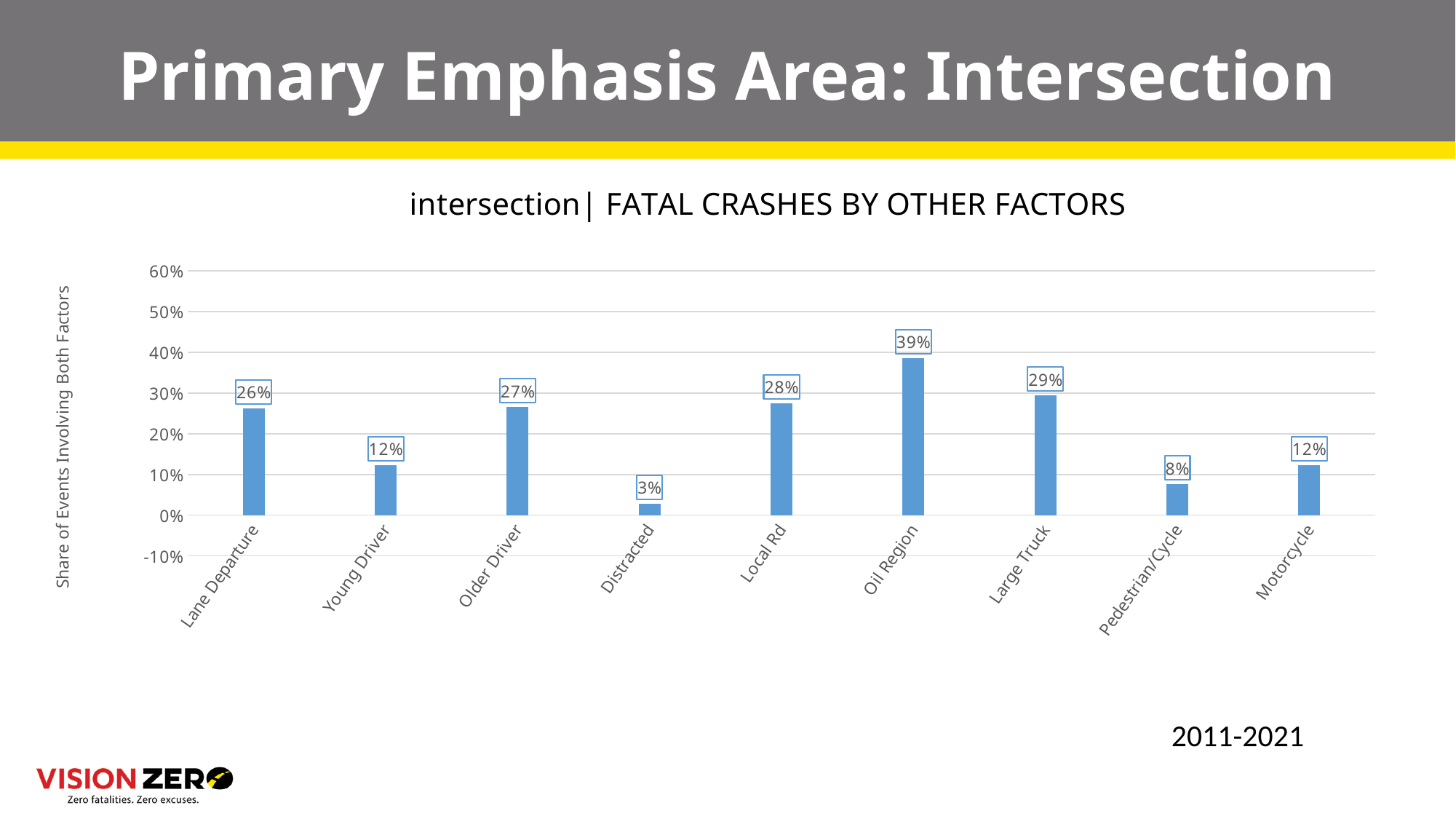
How many categories are shown on the x axis? 9 What is the value for Large Truck? 29% What is the difference between the values for Oil Region and Lane Departure? 13% What is the value for Pedestrian/Cycle? 8% Which category has the highest value? Oil Region What is the label of the vertical axis? Share of Events Involving Both Factors What is the value for Oil Region? 39% Which is larger, the value for Local Rd or the value for Young Driver? Local Rd Which category has the lowest value? Distracted What is the value for Distracted? 3% What kind of chart is shown on the slide? Bar chart What is the title of the chart? intersection| FATAL CRASHES BY OTHER FACTORS